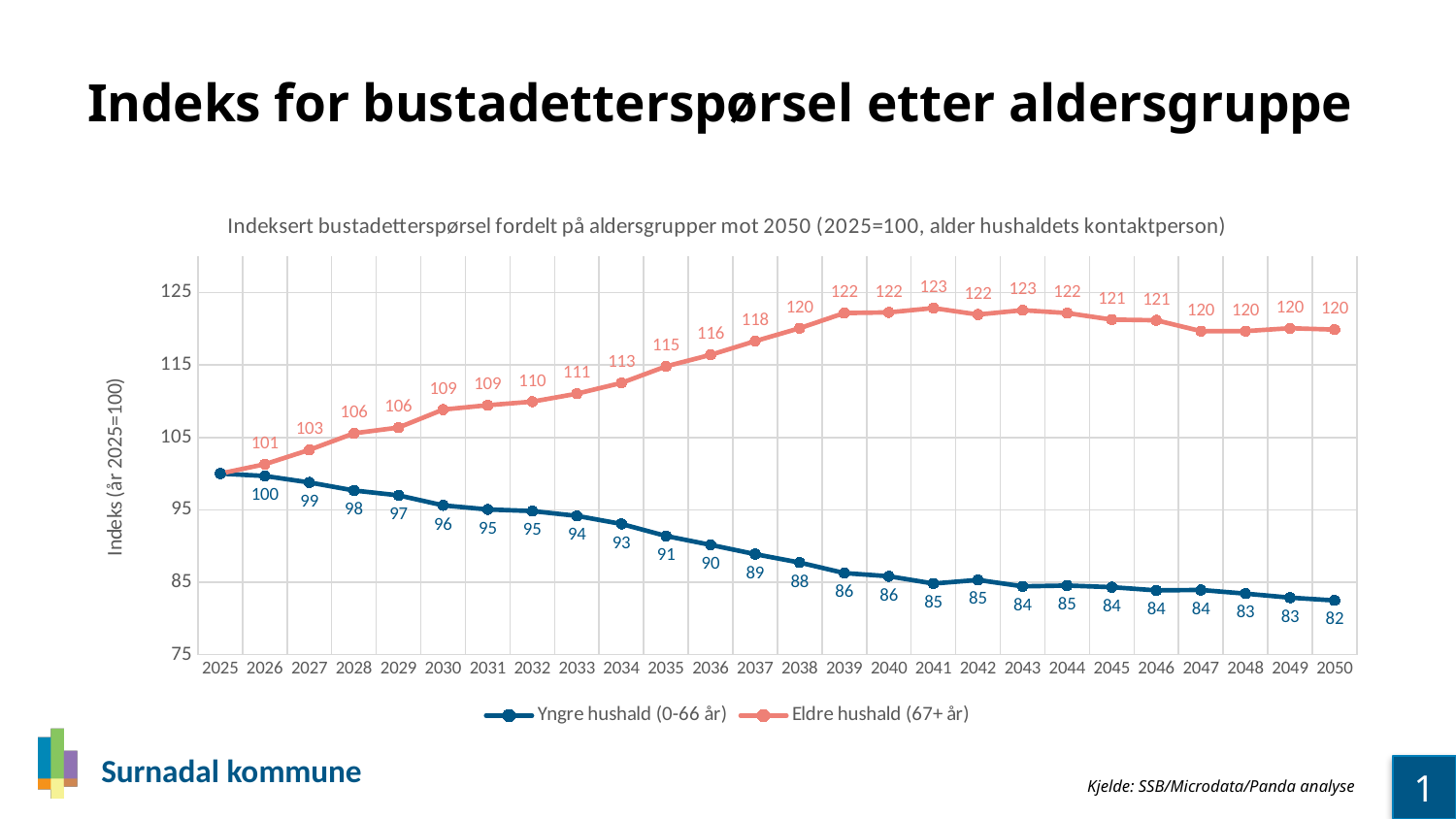
Does the Eldre hushald (67+ år) series rise or fall from 2025 to 2039? rise Is the value for Eldre hushald (67+ år) in 2045 greater or less than 115? greater Does the Yngre hushald (0-66 år) series rise or fall from 2025 to 2050? fall What kind of chart is shown on the slide? line chart What is the value for Yngre hushald (0-66 år) in 2040? 86 How many series does the legend list? 2 How many years are shown on the x axis? 26 What is the value for Eldre hushald (67+ år) in 2035? 115 What is the difference between the Eldre hushald (67+ år) and Yngre hushald (0-66 år) values in 2050? 38 Which series has the higher value in 2038, Yngre hushald (0-66 år) or Eldre hushald (67+ år)? Eldre hushald (67+ år) What is the value for Yngre hushald (0-66 år) in 2050? 82 What is the value for Eldre hushald (67+ år) in 2050? 120